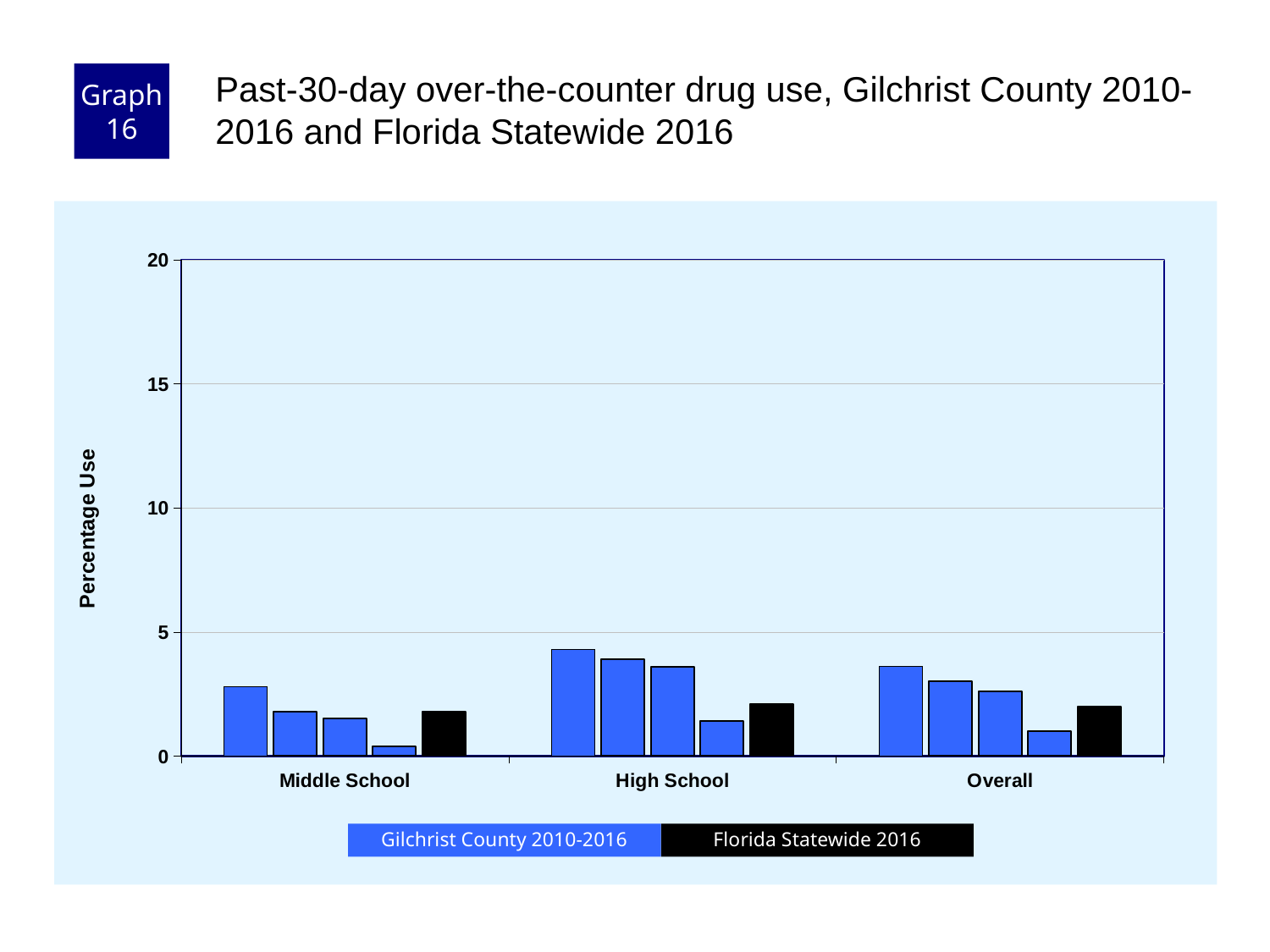
Is the Florida Statewide 2016 value for High School greater or less than 5? less Within each category, do the Gilchrist County 2010-2016 bars rise or fall from left to right? fall What kind of chart is shown on the slide? bar chart Which category contains the tallest bar on the chart? High School Is the first (leftmost) Gilchrist County bar for High School taller or shorter than the first Gilchrist County bar for Middle School? taller How many series does the legend list? 2 How many Gilchrist County 2010-2016 bars are shown for the High School category? 4 How many categories are shown on the x axis? 3 Which category contains the shortest bar on the chart? Middle School Is the tallest Gilchrist County 2010-2016 bar for High School greater or less than 5? less What is the title of the y axis? Percentage Use Is the Florida Statewide 2016 value for Overall greater or less than 5? less